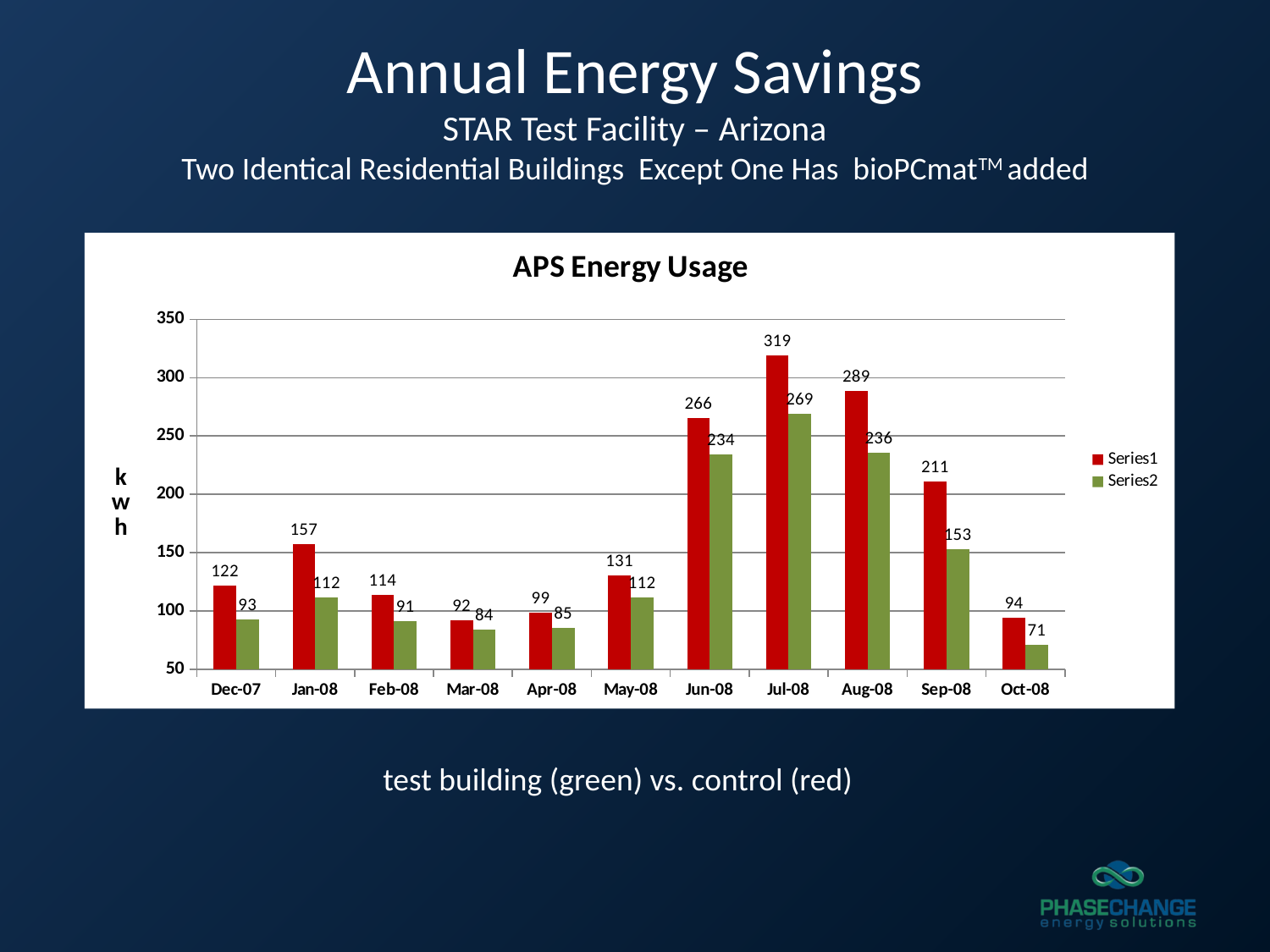
Which month has the lowest Series2 value? Oct-08 How many months are shown on the x axis? 11 Do the Series1 values rise or fall from Jul-08 to Oct-08? fall How many series does the legend list? 2 Which month has the highest Series1 value? Jul-08 Is the Series2 value for Jun-08 greater or less than 200? greater What is the Series1 value for Jul-08? 319 What is the difference between the Series1 and Series2 values for Aug-08? 53 Which is larger for Jan-08, the Series1 value or the Series2 value? Series1 What is the Series2 value for Mar-08? 84 What kind of chart is shown? bar chart What is the title of the chart? APS Energy Usage